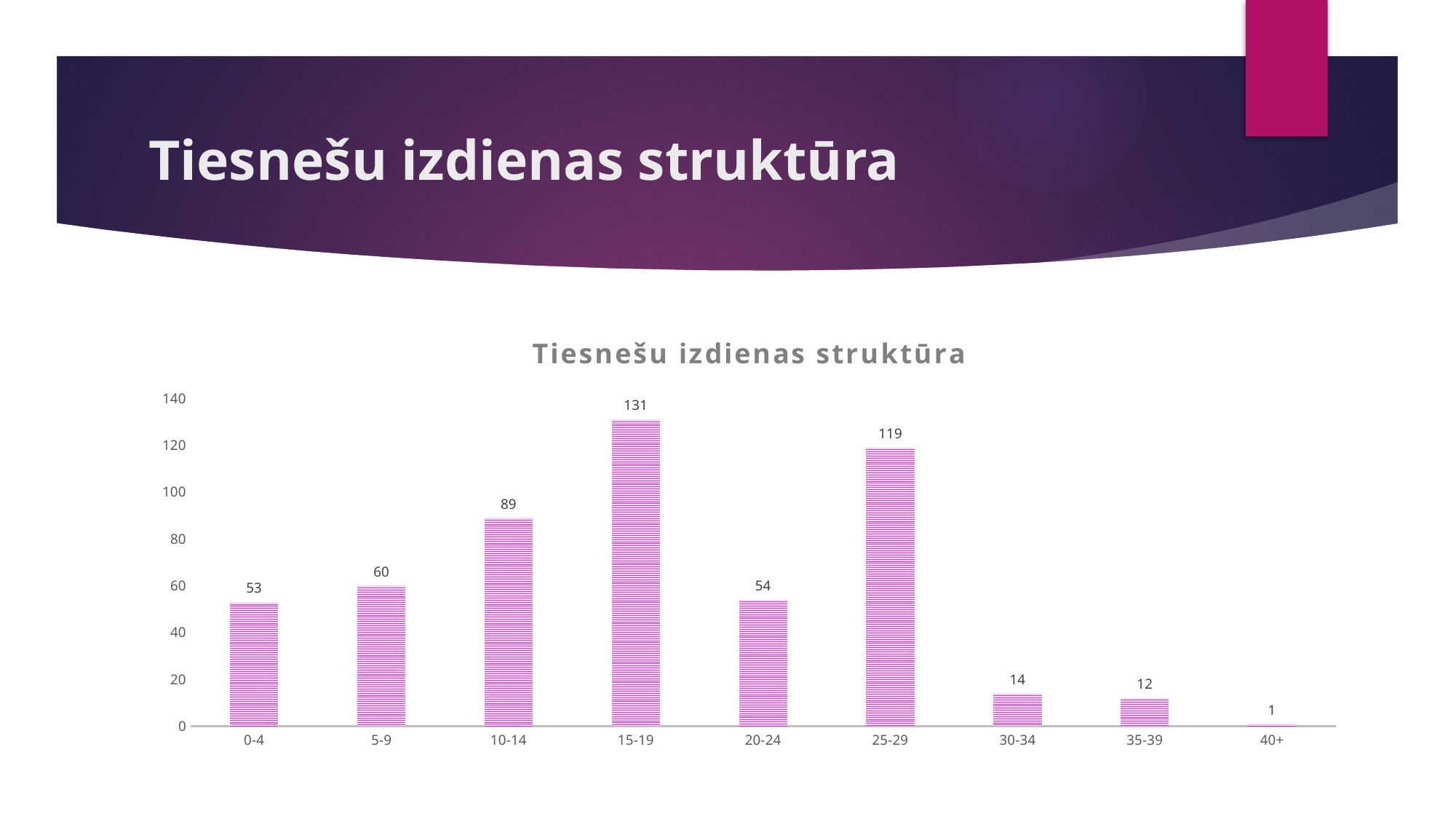
What kind of chart is shown on the slide? Bar chart How many categories are shown on the x axis? 9 Which category has the lowest value? 40+ Which is larger, the value for 20-24 or the value for 0-4? 20-24 What is the title of the chart? Tiesnešu izdienas struktūra What is the value for the 0-4 category? 53 Which category has the highest value? 15-19 What is the value for the 15-19 category? 131 Is the value for 10-14 greater or less than 80? greater What is the difference between the values for 15-19 and 25-29? 12 What is the value for the 25-29 category? 119 What is the difference between the values for 10-14 and 5-9? 29